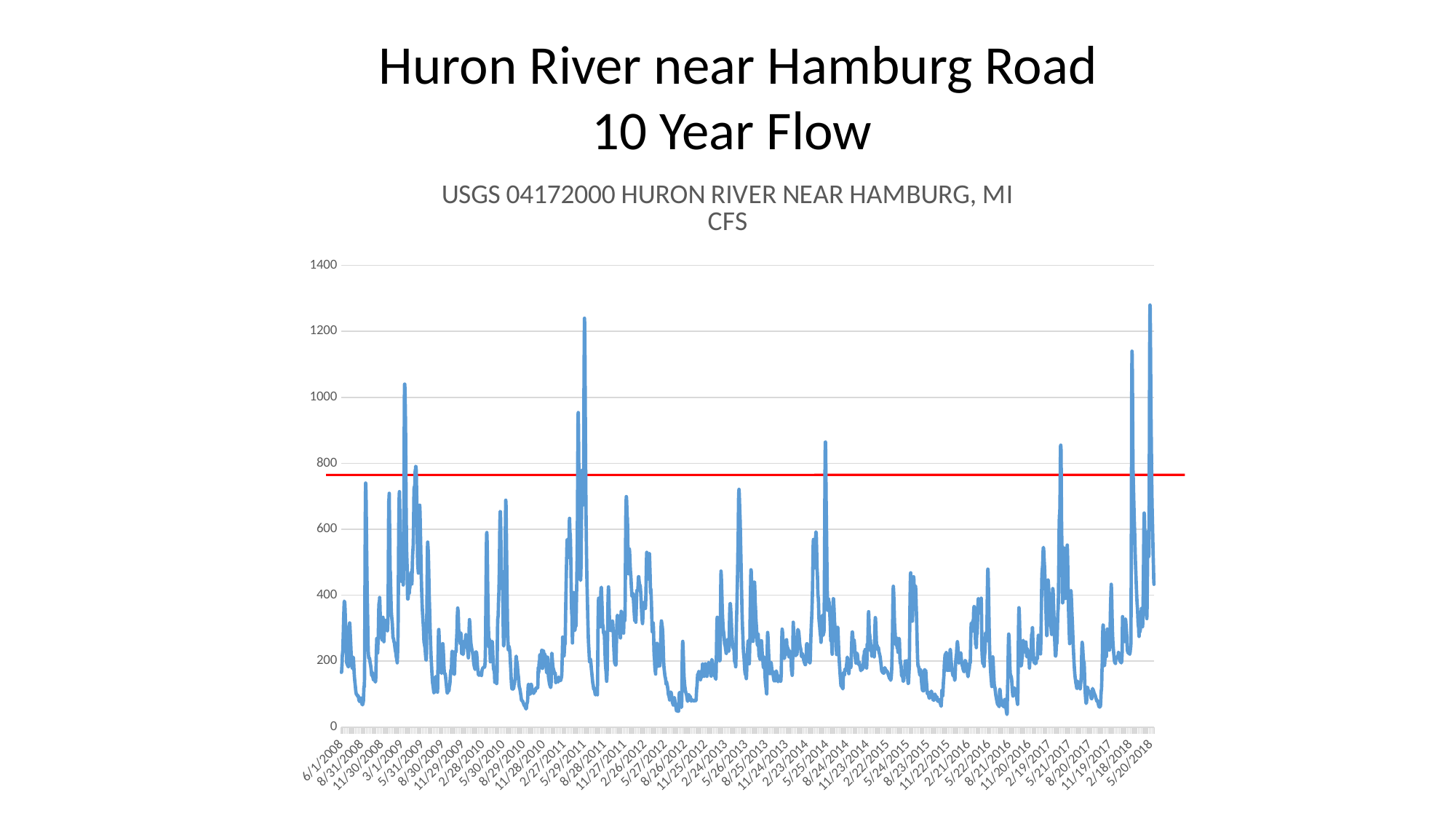
What kind of chart is shown on the slide? line chart Is the lowest value of the flow line, near 8/21/2016, greater or less than 200? less Which peak is higher: the one near 5/29/2011 or the one near 5/25/2014? 5/29/2011 Is the peak of the flow line near 2/18/2018 greater or less than 1000? greater Which peak is higher: the one near 5/20/2018 or the one near 3/1/2009? 5/20/2018 Is the peak of the flow line near 3/1/2009 greater or less than 800? greater What colour is the horizontal reference line drawn across the chart? red What is the title printed above the chart? USGS 04172000 HURON RIVER NEAR HAMBURG, MI CFS